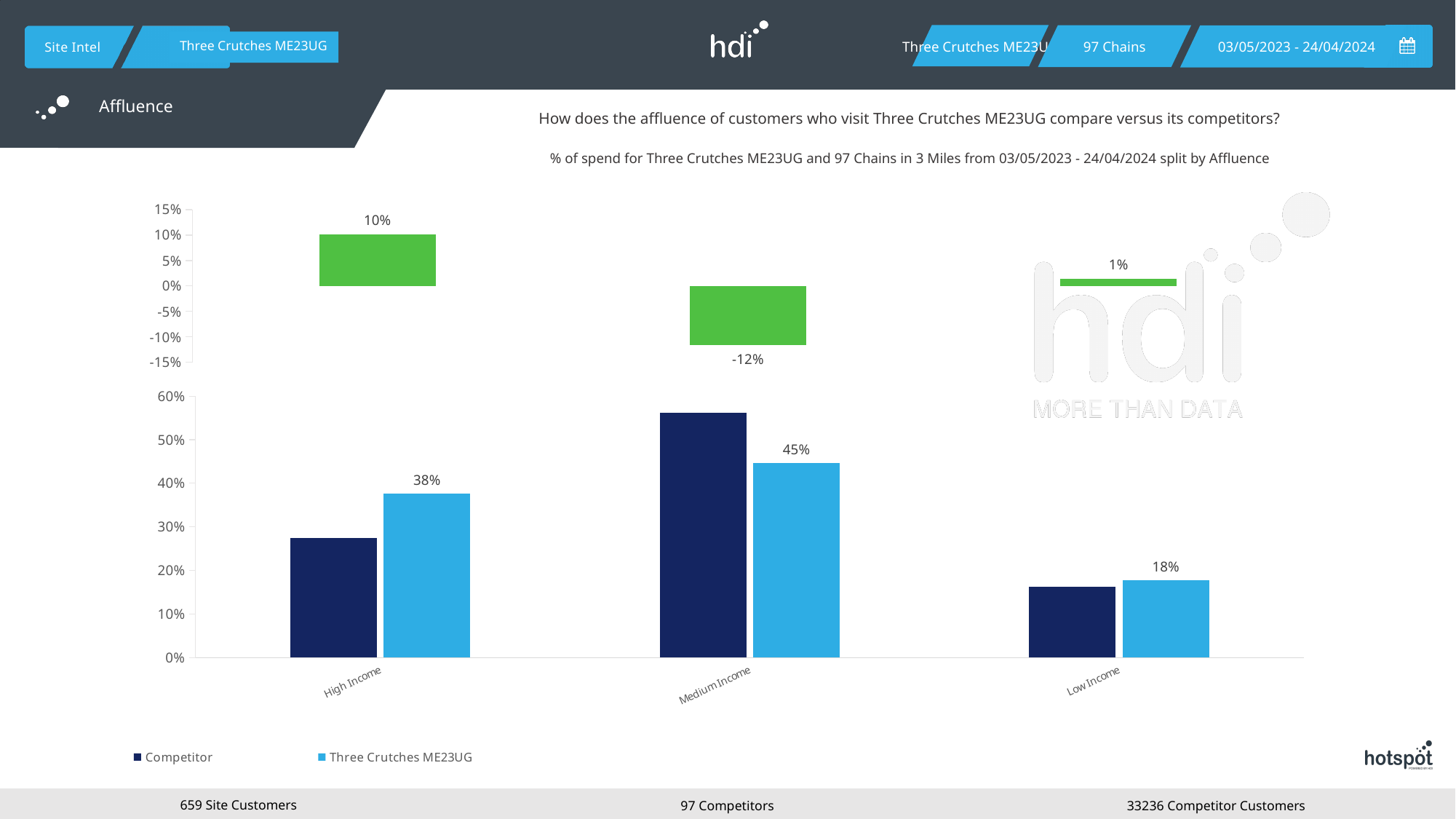
In the bottom chart, is the Competitor value for High Income greater or less than 30%? less In the bottom chart, which is larger in the Medium Income category: Competitor or Three Crutches ME23UG? Competitor How many series does the legend of the bottom chart list? 2 In the bottom chart, which category has the highest value for Three Crutches ME23UG? Medium Income In the bottom chart, what is the difference between the Three Crutches ME23UG values for Medium Income and Low Income? 27% In the bottom chart, what is the value for Three Crutches ME23UG in the High Income category? 38% In the bottom chart, what is the value for Three Crutches ME23UG in the Medium Income category? 45% In the top chart, what is the value shown for the Medium Income category? -12% In the top chart, which category has the lowest value? Medium Income In the top chart, what is the value shown for the High Income category? 10% In the bottom chart, what is the value for Three Crutches ME23UG in the Low Income category? 18% In the bottom chart, is the Competitor value for Medium Income greater or less than 50%? greater